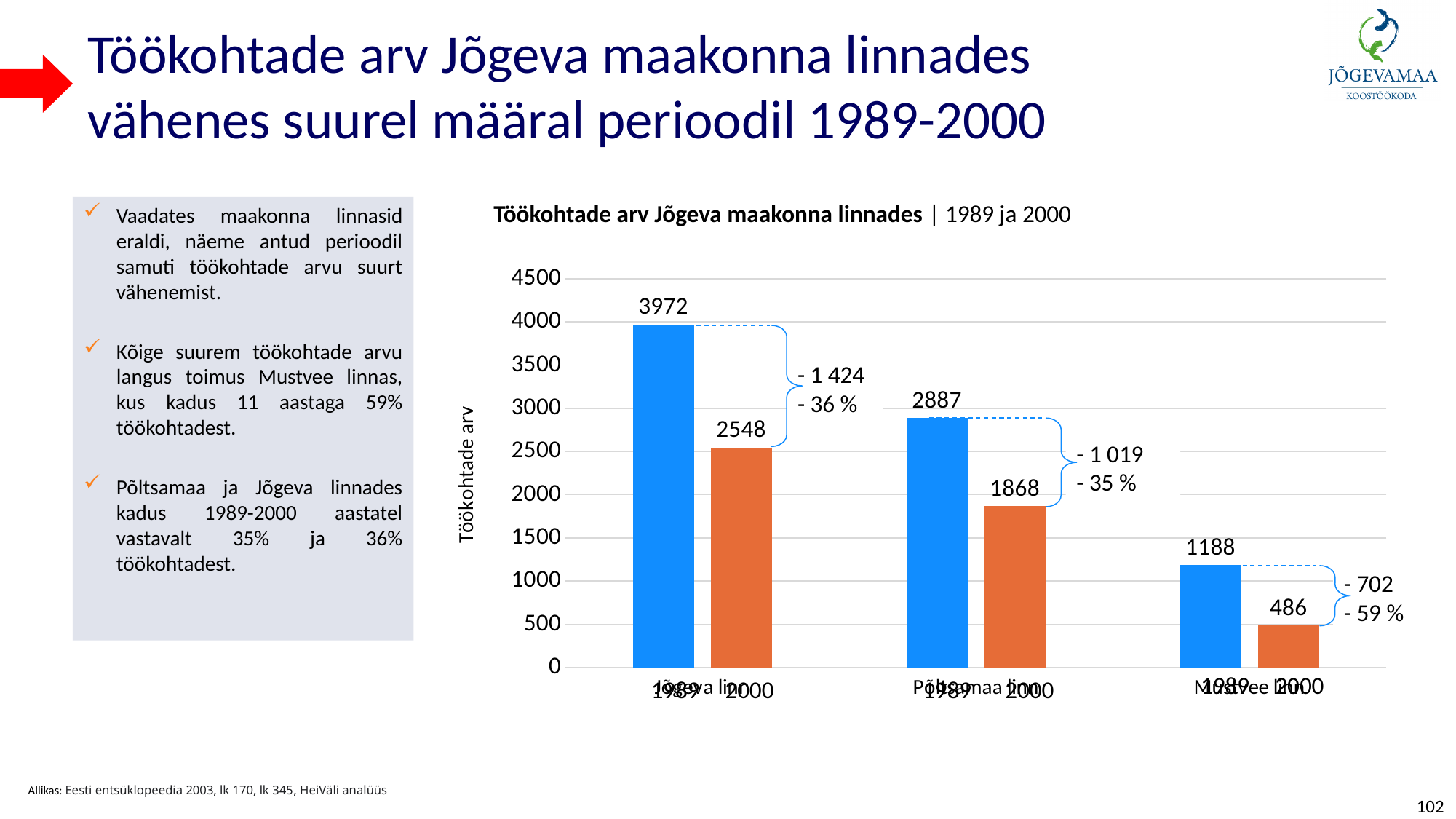
How many towns are shown on the x axis of the chart? 3 What was the number of jobs in Mustvee linn in 2000? 486 By how much did the number of jobs in Jõgeva linn fall between 1989 and 2000? 1 424 What kind of chart is shown on the slide? Bar chart Which town had the lowest number of jobs in 2000? Mustvee linn What was the number of jobs in Põltsamaa linn in 2000? 1868 What is the difference between the 1989 and 2000 job counts for Mustvee linn? 702 Is the 1989 value for Mustvee linn greater or less than 1000? greater What was the number of jobs in Jõgeva linn in 1989? 3972 Which town had the highest number of jobs in 1989? Jõgeva linn What percentage decrease is annotated for Mustvee linn? - 59 % Which is larger: the 2000 value for Jõgeva linn or the 1989 value for Põltsamaa linn? 1989 value for Põltsamaa linn